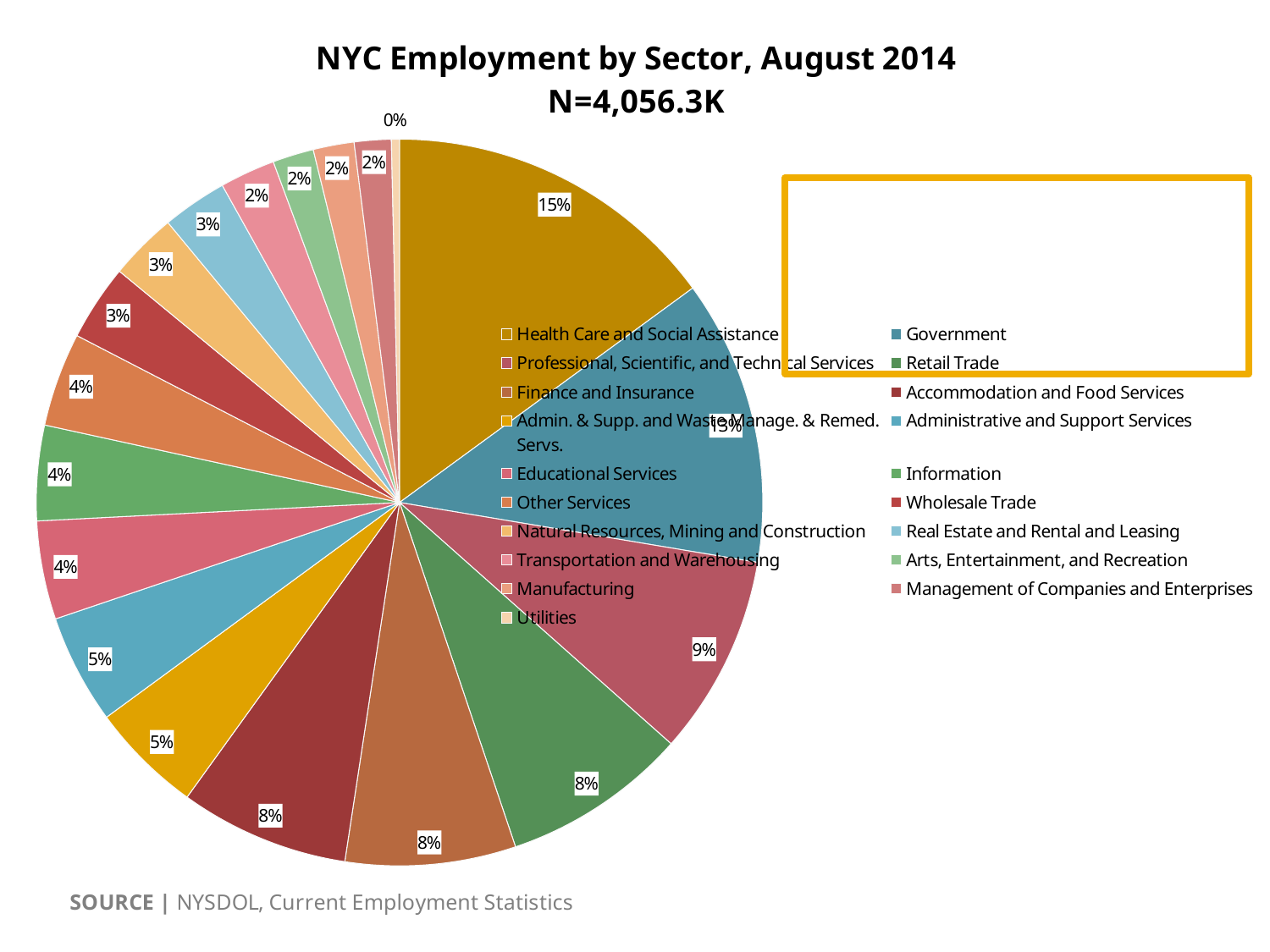
What is the largest percentage shown on any slice of the pie? 15% What share of NYC employment is Retail Trade? 8% What kind of chart is shown on the slide? pie chart What is the title of the chart? NYC Employment by Sector, August 2014 N=4,056.3K What is the difference in percentage points between the Health Care and Social Assistance share and the Professional, Scientific, and Technical Services share? 6% Which has a larger share, Professional, Scientific, and Technical Services or Retail Trade? Professional, Scientific, and Technical Services What share of NYC employment is Health Care and Social Assistance? 15% What is the total employment (N) stated in the chart title? 4,056.3K How many sectors does the legend list? 19 What share of NYC employment is Government? 13% What is the smallest percentage shown on any slice of the pie? 0%